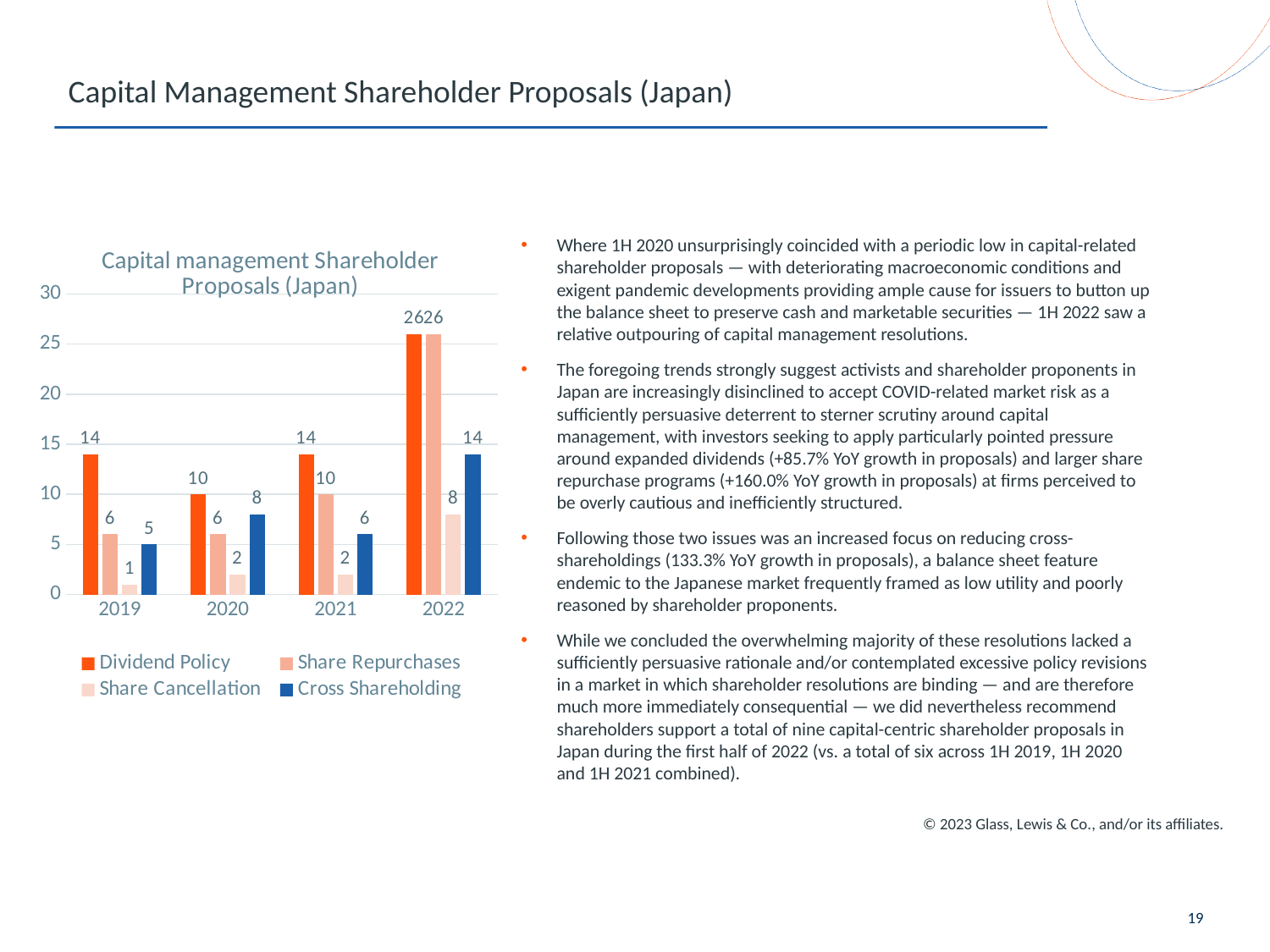
How many years are shown on the x axis? 4 What is the title of the chart? Capital management Shareholder Proposals (Japan) What type of chart is shown on the slide? Bar chart What is the value for Share Cancellation in 2019? 1 What is the difference between the Dividend Policy values for 2022 and 2021? 12 Which is larger in 2020: Share Repurchases or Cross Shareholding? Cross Shareholding What is the value for Share Repurchases in 2021? 10 What is the value for Dividend Policy in 2022? 26 In which year is the Dividend Policy value lowest? 2020 How many series does the legend list? 4 What is the value for Cross Shareholding in 2020? 8 In which year is the Cross Shareholding value highest? 2022